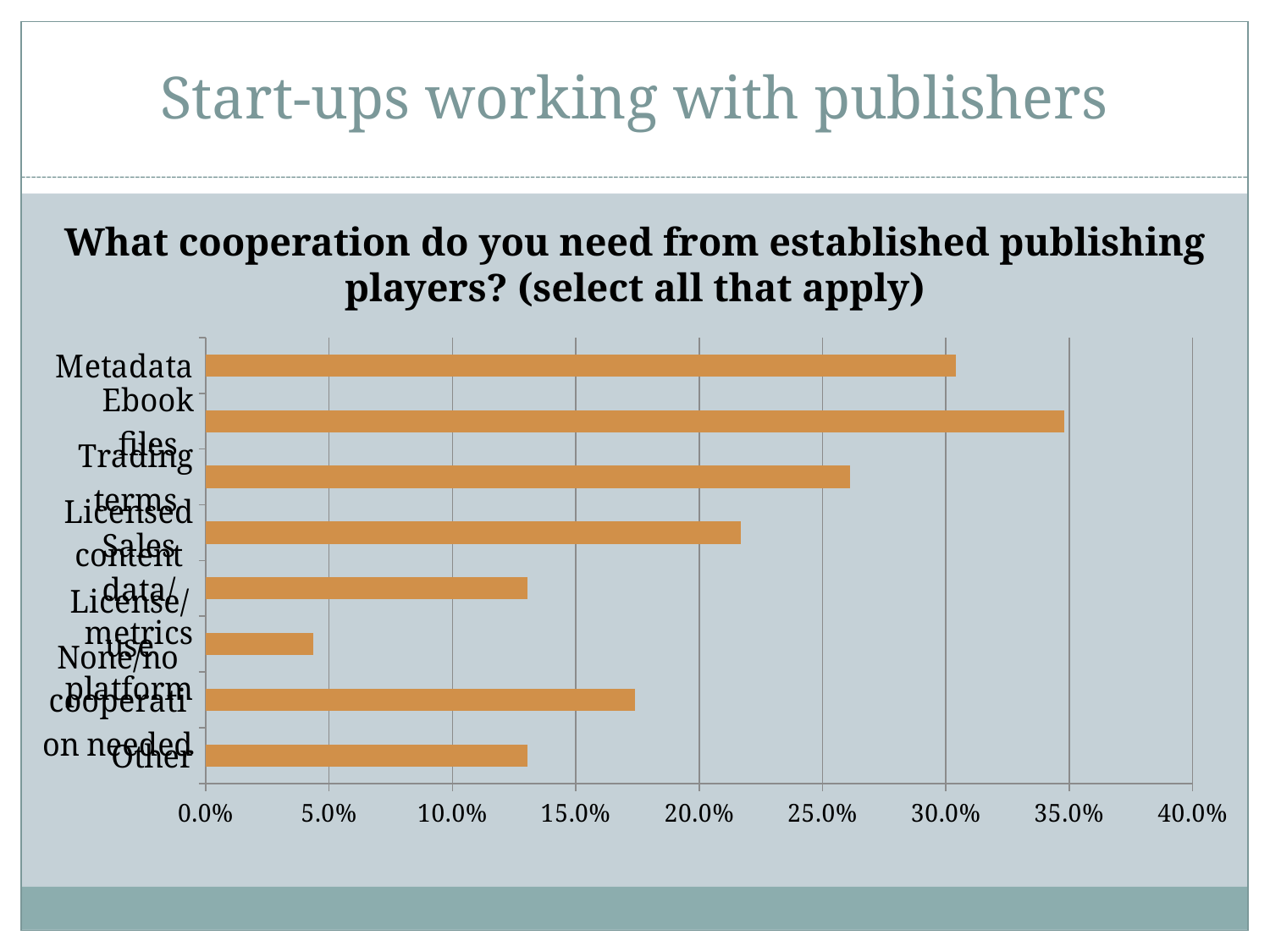
Is the value for License/use platform greater or less than 5.0%? less Which is larger, the value for None/no cooperation needed or the value for Sales data/metrics? None/no cooperation needed Is the value for Trading terms greater or less than 25.0%? greater Which category has the lowest value in the chart? License/use platform Is the value for Licensed content greater or less than 20.0%? greater How many categories are plotted in the chart? 8 What is the title of the chart? What cooperation do you need from established publishing players? (select all that apply) What kind of chart is shown on the slide? bar chart Which is larger, the value for Metadata or the value for Trading terms? Metadata Which category has the highest value in the chart? Ebook files